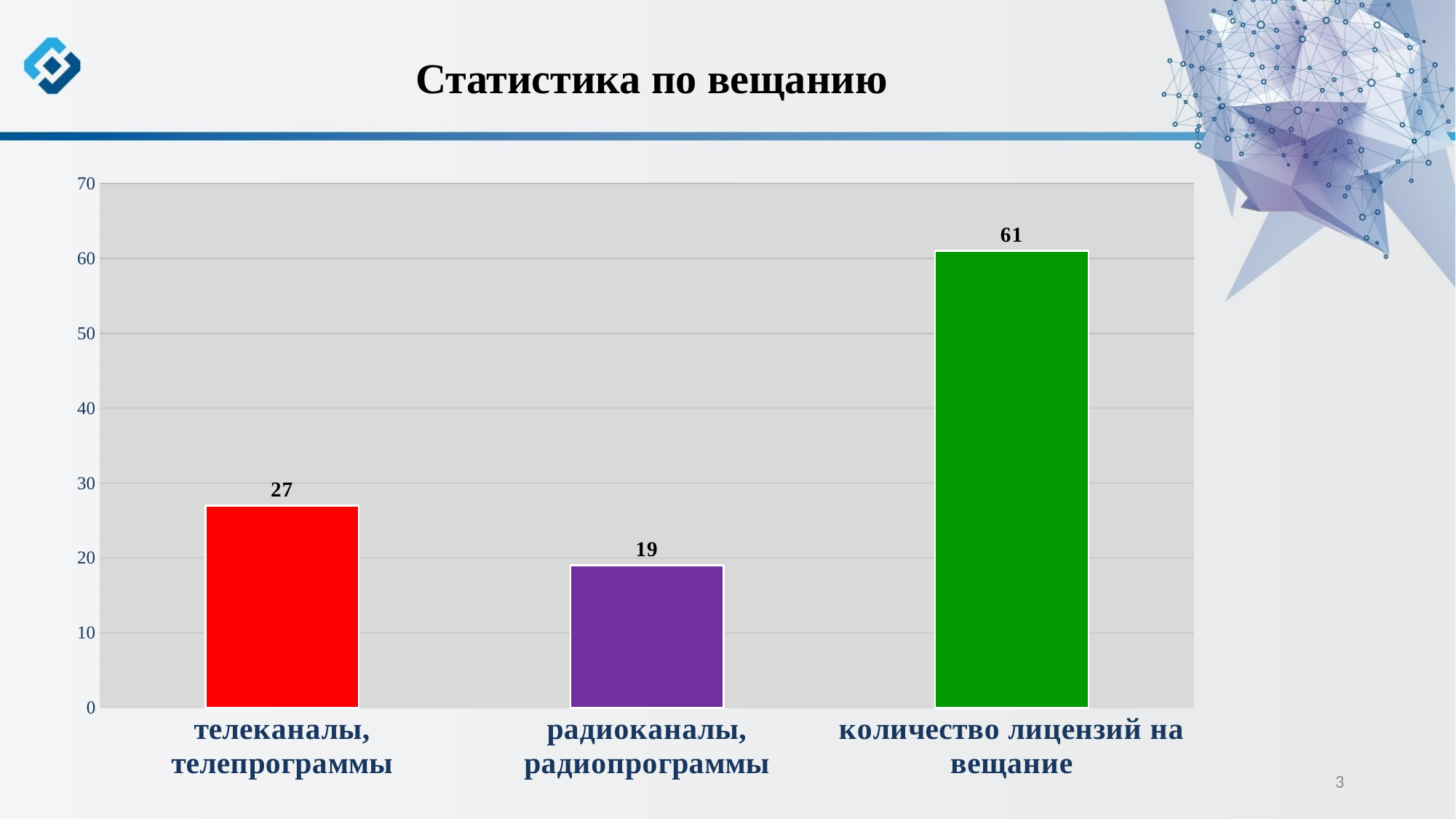
What is the value for радиоканалы, радиопрограммы? 19 Which is larger: the value for телеканалы, телепрограммы or the value for радиоканалы, радиопрограммы? телеканалы, телепрограммы What is the value for телеканалы, телепрограммы? 27 What is the difference between the values for количество лицензий на вещание and телеканалы, телепрограммы? 34 Which category has the lowest value? радиоканалы, радиопрограммы What is the difference between the values for телеканалы, телепрограммы and радиоканалы, радиопрограммы? 8 How many categories are shown in the chart? 3 What kind of chart is shown on the slide? bar chart Which category has the highest value? количество лицензий на вещание What is the title of the slide? Статистика по вещанию Is the value for количество лицензий на вещание greater or less than 50? greater What is the value for количество лицензий на вещание? 61